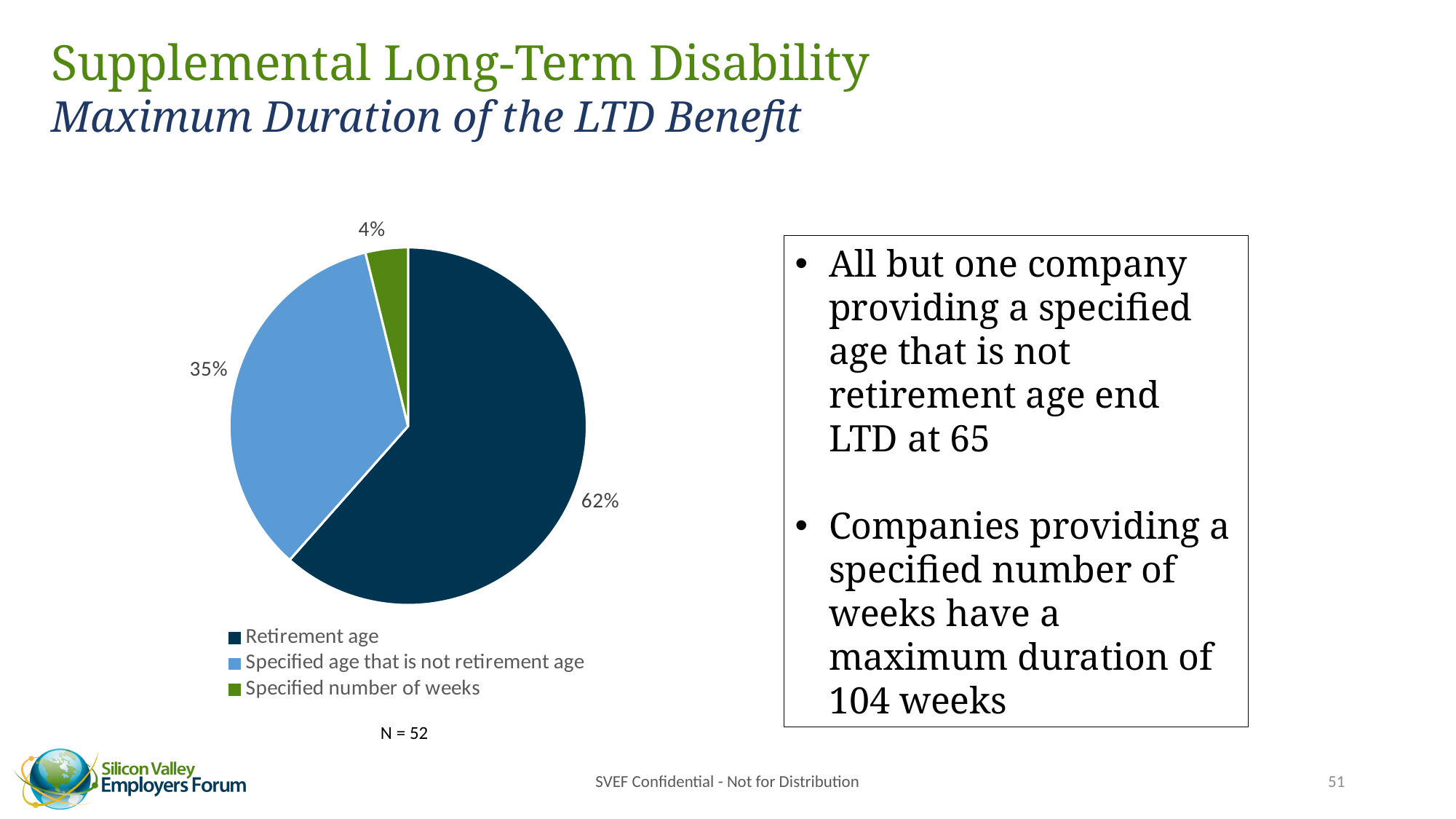
Which is larger: the slice for Specified age that is not retirement age or the slice for Specified number of weeks? Specified age that is not retirement age What is the difference in percentage points between the Retirement age slice and the Specified age that is not retirement age slice? 27 What colour is the slice for Specified number of weeks? Green Which category has the largest slice of the pie? Retirement age What kind of chart is shown on the slide? Pie chart What share of the pie is labelled for Retirement age? 62% What is the sample size (N) noted below the chart? N = 52 Which category has the smallest slice of the pie? Specified number of weeks What share of the pie is labelled for Specified number of weeks? 4% What share of the pie is labelled for Specified age that is not retirement age? 35% How many categories does the pie chart show? 3